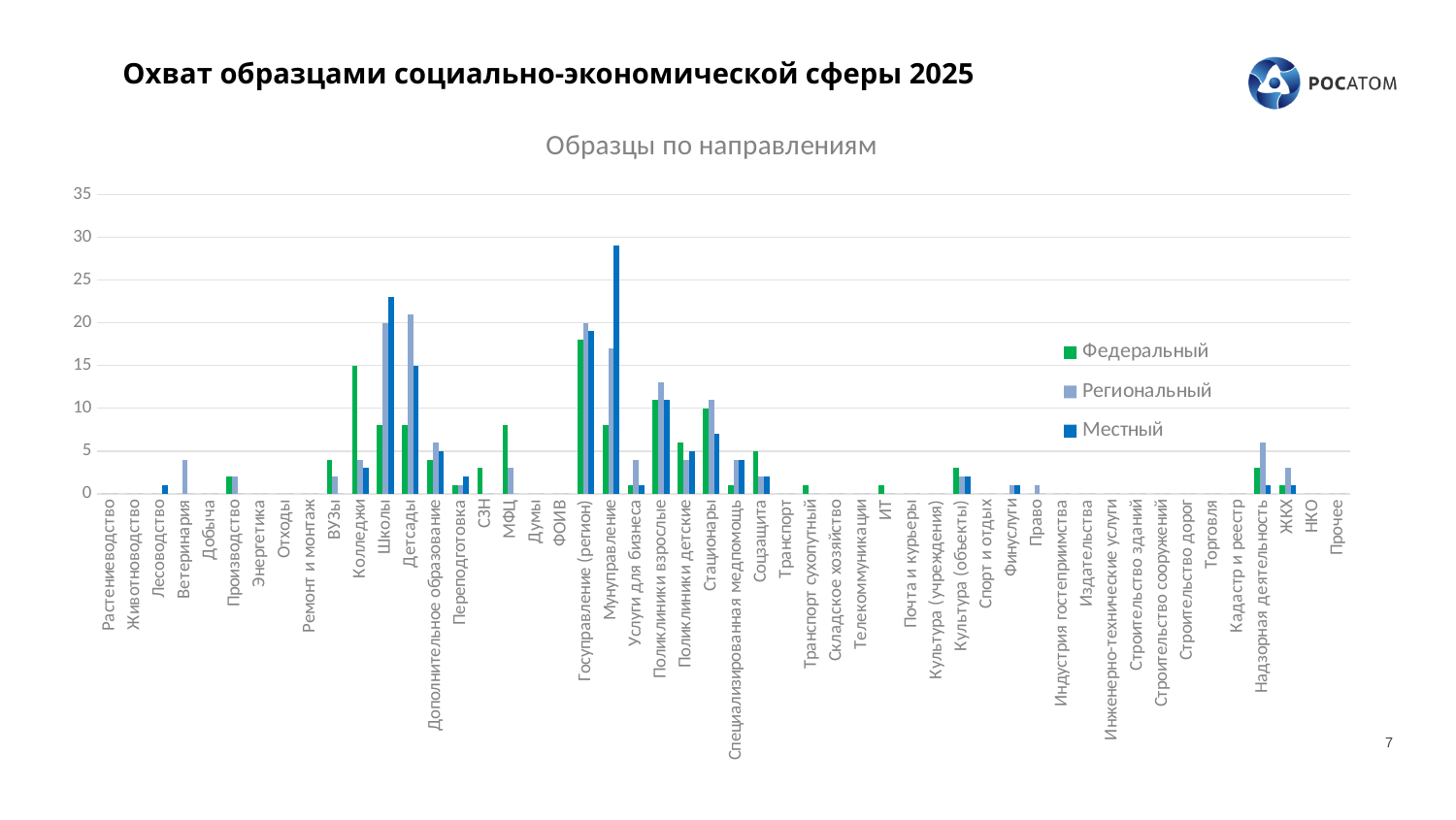
Is the Региональный value for Поликлиники взрослые greater or less than 10? greater Which series has the tallest bar for Детсады? Региональный What is the title of the chart? Образцы по направлениям Is the Федеральный value for Колледжи greater or less than 10? greater How many series does the legend list? 3 For Школы, which series has the larger value: Федеральный or Местный? Местный Which category has the tallest Местный bar? Мунуправление Is the Местный value for Школы greater or less than 20? greater Which colour represents the Федеральный series in the chart? green What type of chart is shown on the slide? bar chart